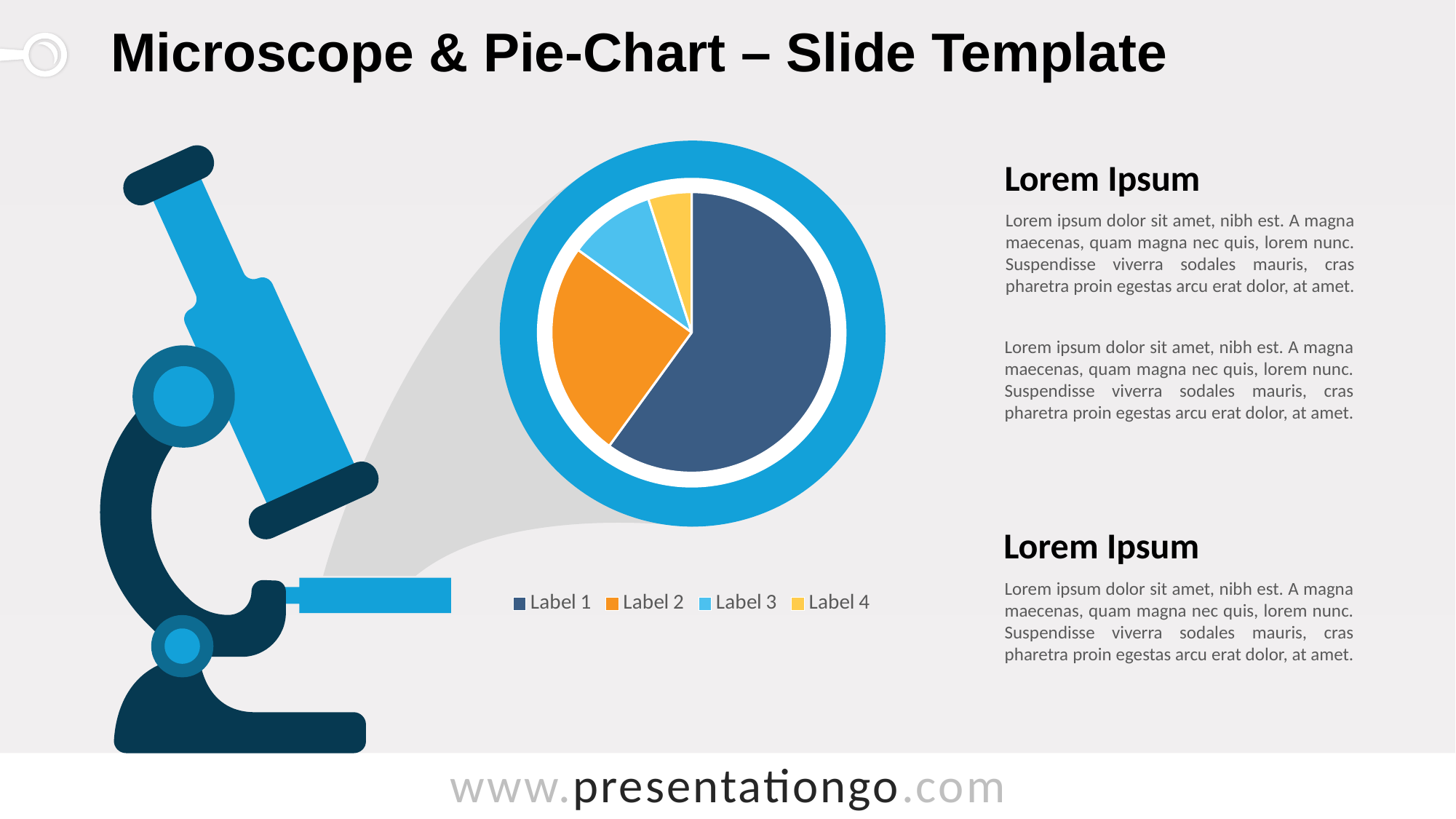
What colour is the Label 2 slice in the pie chart? orange What colour is the Label 4 slice in the pie chart? yellow Which slice of the pie chart is the smallest? Label 4 Which slice is larger in the pie chart, Label 3 or Label 4? Label 3 How many slices does the pie chart have? 4 Which slice is larger in the pie chart, Label 1 or Label 2? Label 1 Does the Label 1 slice take up more or less than half of the pie chart? more Which slice of the pie chart is the largest? Label 1 How many entries does the legend of the pie chart list? 4 What kind of chart is shown on the slide? pie chart Which slice is larger in the pie chart, Label 2 or Label 3? Label 2